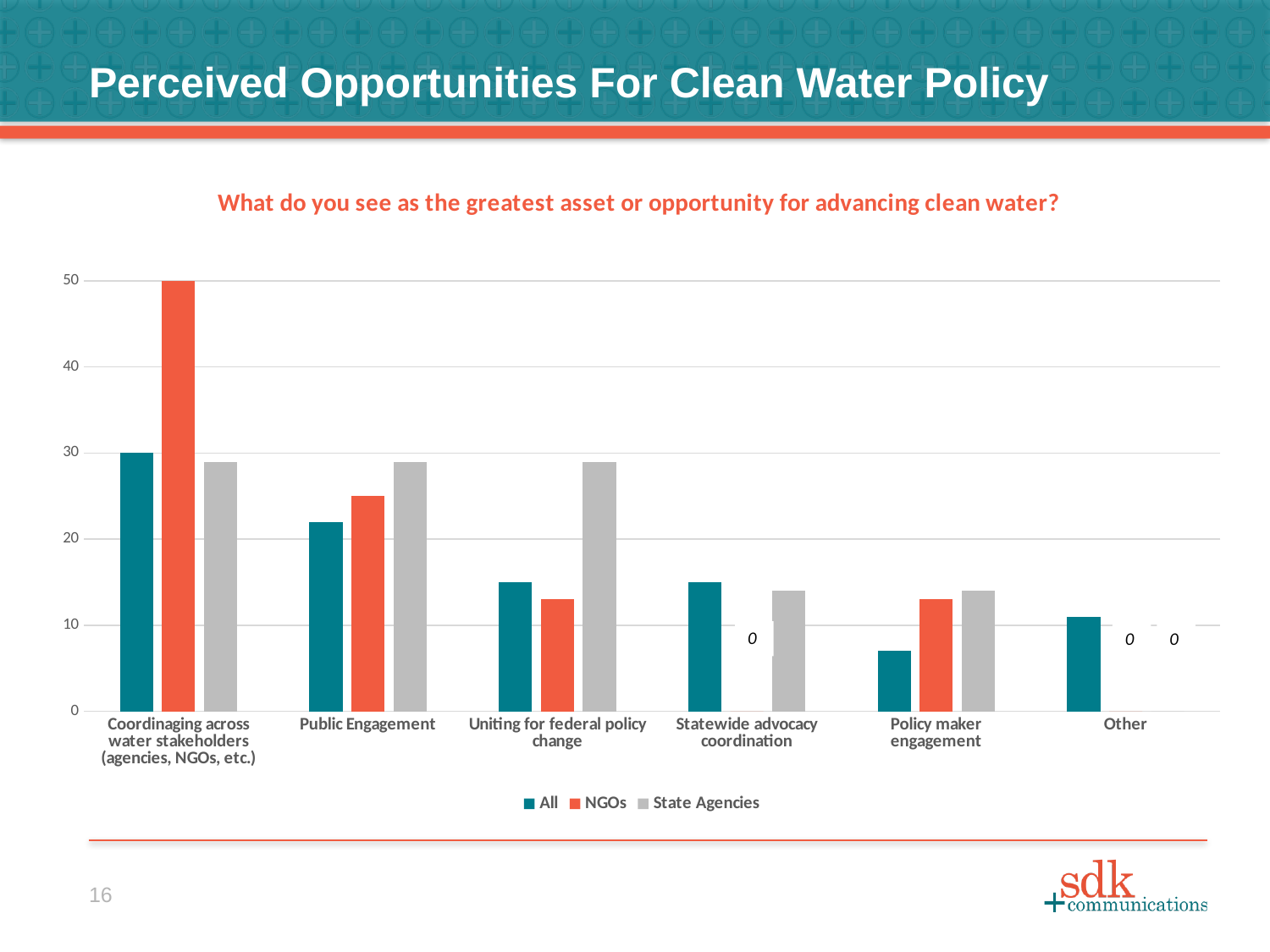
How many categories are shown along the x axis? 6 What question is posed in the chart's subtitle? What do you see as the greatest asset or opportunity for advancing clean water? How many series does the legend list? 3 Is the value for All in the Policy maker engagement category greater or less than 10? less In the Public Engagement category, which is larger: the All bar or the NGOs bar? NGOs Which category has the tallest bar overall in the chart? Coordinating across water stakeholders (agencies, NGOs, etc.) What is the value for NGOs in the Coordinating across water stakeholders category? 50 What kind of chart is shown on the slide? bar chart What is the value for NGOs in the Statewide advocacy coordination category? 0 Which series has the highest bar in the Coordinating across water stakeholders category? NGOs Is the value for State Agencies in the Uniting for federal policy change category greater or less than 20? greater What is the value for State Agencies in the Other category? 0